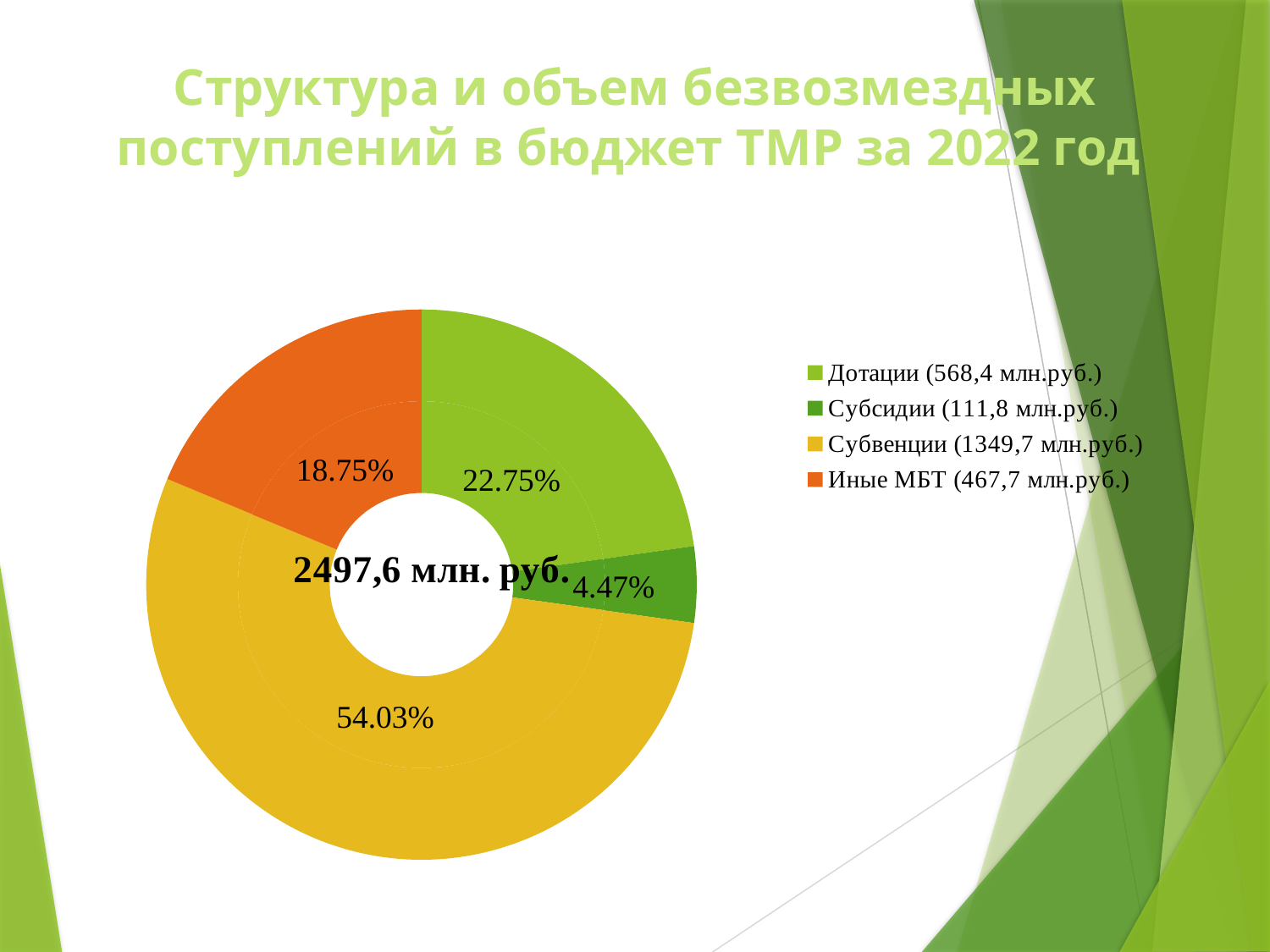
What is the difference in percentage points between the shares of Субвенции and Дотации? 31.28 Which category has the smallest share of the chart? Субсидии What share of the chart does Субсидии account for? 4.47% What total amount is printed in the centre of the chart? 2497,6 млн. руб. What share of the chart does Субвенции account for? 54.03% How many categories does the chart show? 4 What kind of chart is shown on the slide? Pie (doughnut) chart Which has a larger share, Дотации or Иные МБТ? Дотации What share of the chart does Иные МБТ account for? 18.75% Which category has the largest share of the chart? Субвенции What amount in млн.руб. does the legend give for Субвенции? 1349,7 млн.руб.